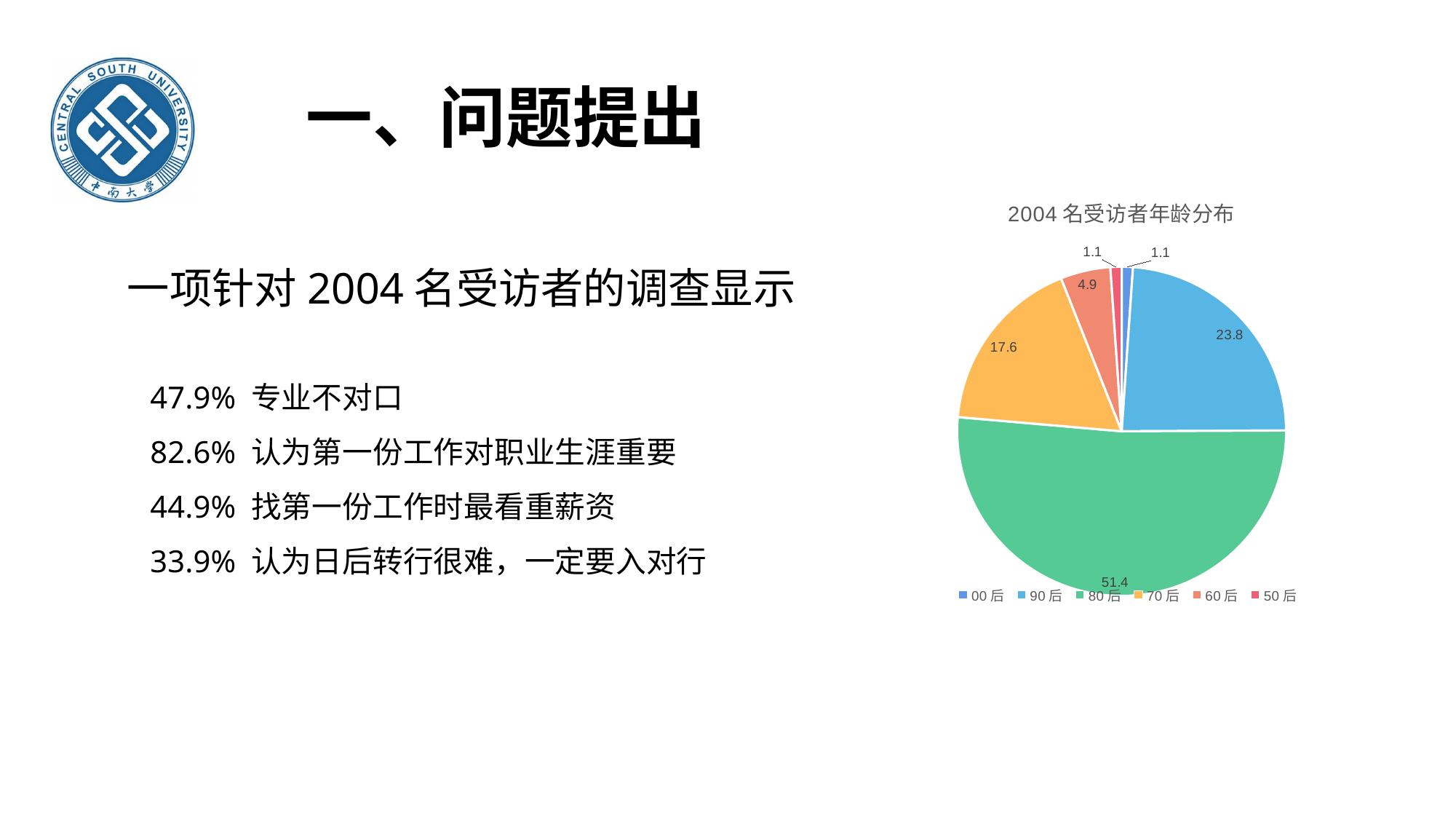
What is the value for 70后 in the pie chart? 17.6 Which age group has the largest slice in the pie chart? 80后 Which colour represents 80后 in the pie chart? green What is the value for 90后 in the pie chart? 23.8 What kind of chart is shown on the slide? pie chart Which is larger, the value for 70后 or the value for 60后? 70后 What is the value for 80后 in the pie chart? 51.4 What is the title of the chart? 2004 名受访者年龄分布 What is the value for 60后 in the pie chart? 4.9 How many categories does the legend of the pie chart list? 6 What is the difference between the values for 80后 and 90后? 27.6 What is the value for 50后 in the pie chart? 1.1